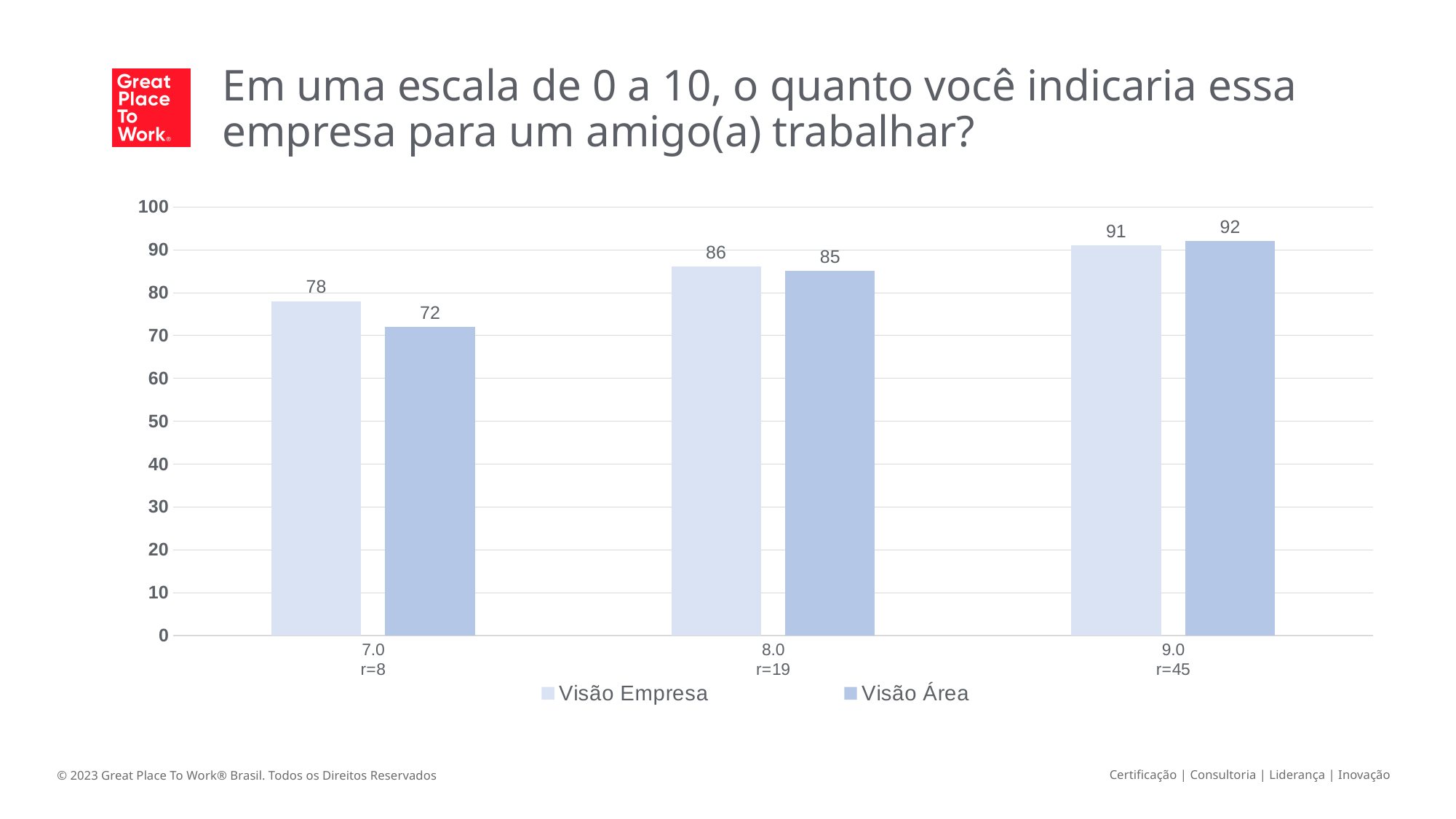
How many categories are shown on the x axis? 3 What is the r value shown under the 8.0 category label? r=19 What kind of chart is shown on the slide? Bar chart Which category has the highest Visão Empresa value? 9.0 What is the difference between Visão Empresa and Visão Área for the 7.0 category? 6 What is the value of Visão Empresa for the 7.0 category? 78 What is the value of Visão Área for the 8.0 category? 85 Which is larger for the 8.0 category, Visão Empresa or Visão Área? Visão Empresa Which category has the lowest Visão Área value? 7.0 What is the value of Visão Área for the 9.0 category? 92 How many series does the legend list? 2 Do the Visão Empresa values rise or fall from 7.0 to 9.0? Rise